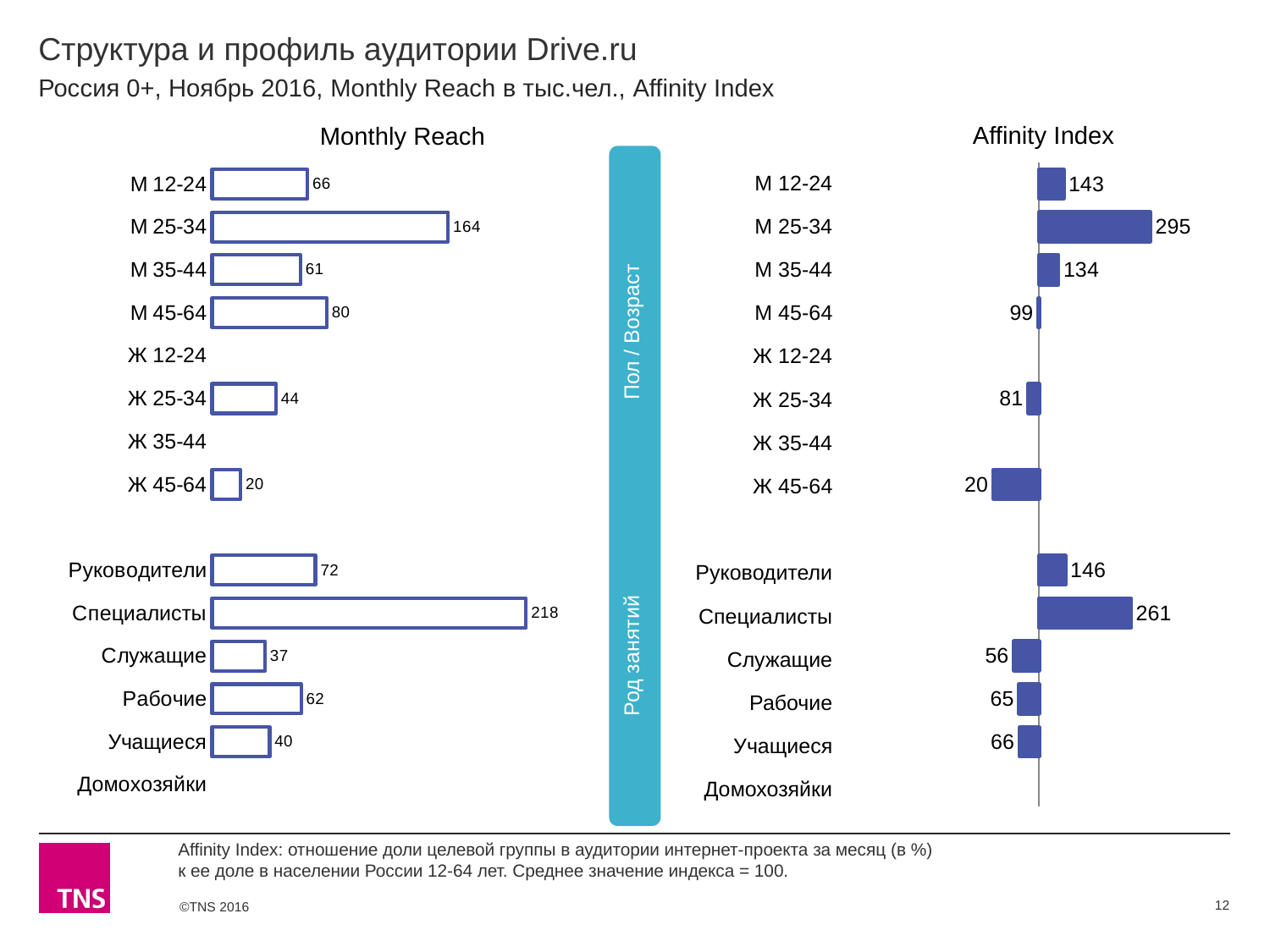
In the Affinity Index chart, what is the value for Специалисты? 261 In the Affinity Index chart, what is the value for Учащиеся? 66 In the Affinity Index chart, which is larger: the value for М 12-24 or the value for М 35-44? М 12-24 In the Affinity Index chart, which category has the lowest value? Ж 45-64 In the Affinity Index chart, what is the difference between the values for М 25-34 and М 45-64? 196 In the Monthly Reach chart, which category has the highest value? Специалисты In the Monthly Reach chart, what is the value for М 25-34? 164 In the Monthly Reach chart, which is larger: the value for Рабочие or the value for Служащие? Рабочие In the Monthly Reach chart, what is the difference between the values for Специалисты and Руководители? 146 What kind of chart is the Monthly Reach chart? Bar chart In the Affinity Index chart, what is the value for Ж 25-34? 81 In the Monthly Reach chart, what is the value for Ж 45-64? 20